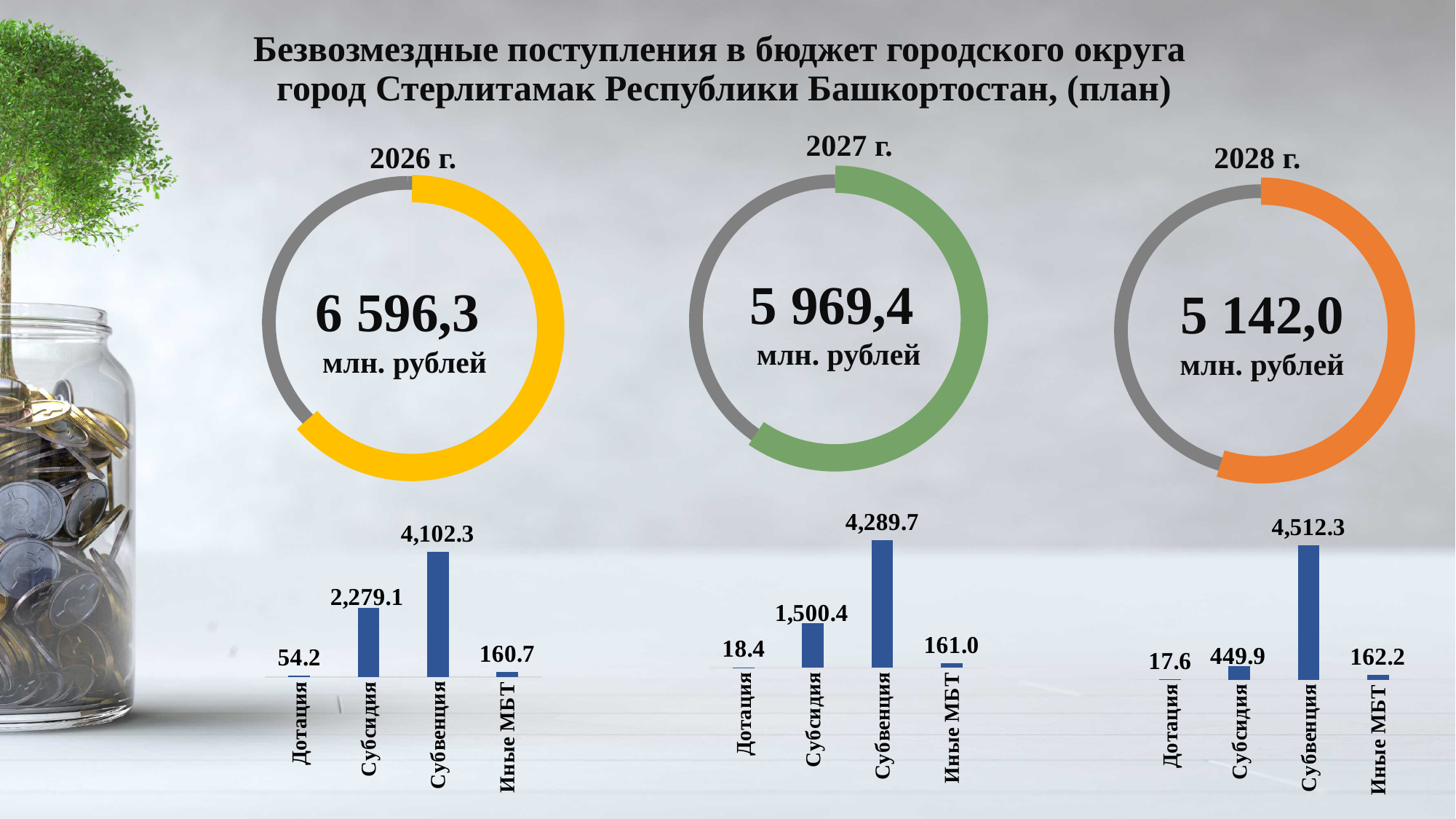
In the 2026 г. bar chart, what is the value for Субвенция? 4,102.3 In the 2028 г. bar chart, which is larger: Субсидия or Иные МБТ? Субсидия In the 2026 г. bar chart, what is the difference between Субвенция and Субсидия? 1,823.2 What colour is the ring chart for 2026 г.? yellow In the 2027 г. bar chart, what is the value for Субсидия? 1,500.4 How many categories does the 2027 г. bar chart show? 4 What kind of chart is used below each year's ring to show Дотация, Субсидия, Субвенция and Иные МБТ? bar chart In the 2028 г. bar chart, what is the value for Дотация? 17.6 In the 2028 г. bar chart, which category has the highest value? Субвенция What total value is shown inside the 2028 г. ring chart? 5 142,0 млн. рублей What total value is shown inside the 2027 г. ring chart? 5 969,4 млн. рублей In the 2027 г. bar chart, which category has the lowest value? Дотация